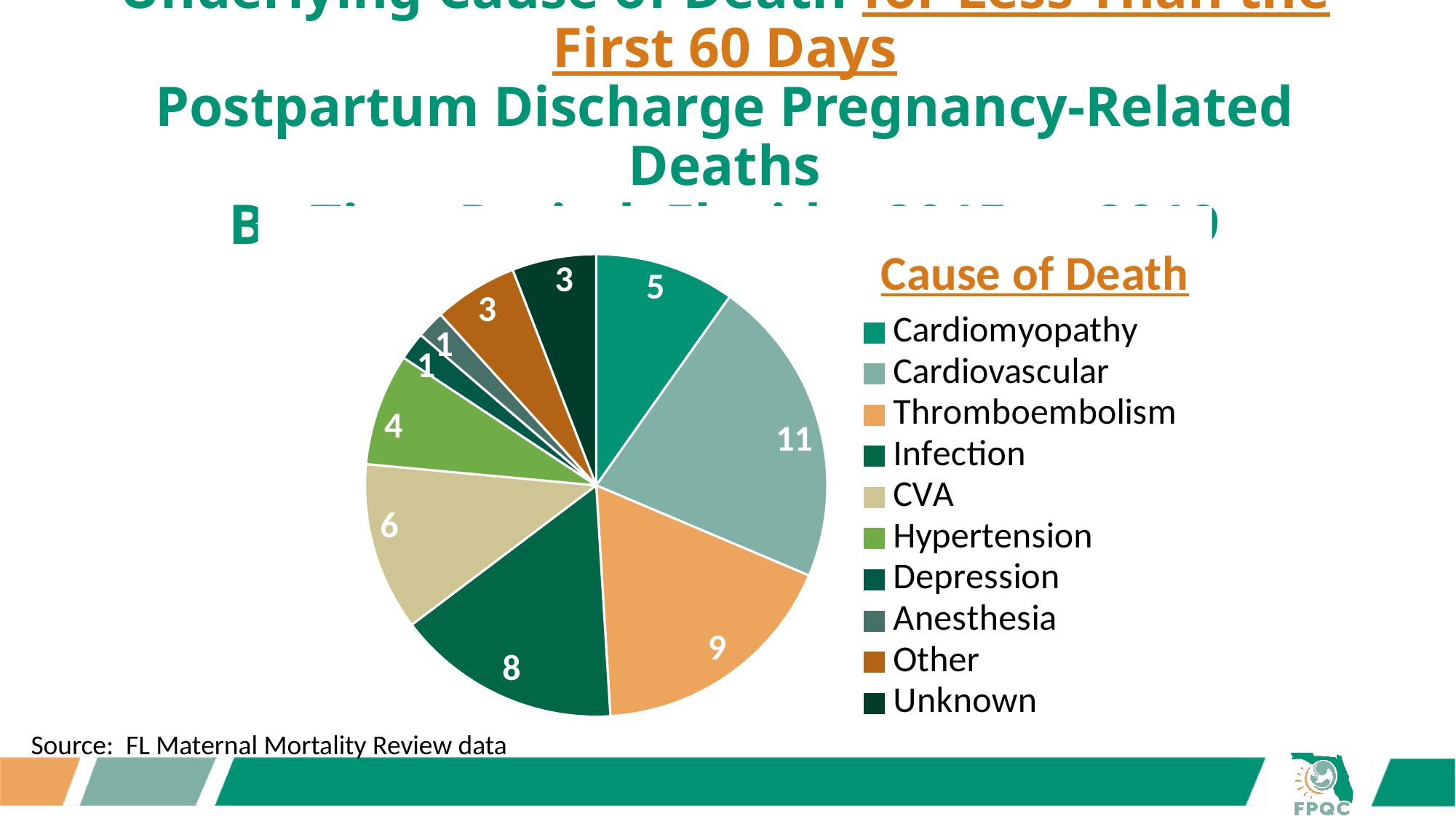
What kind of chart is shown on the slide? Pie chart Which causes of death have the smallest slices in the pie chart? Depression and Anesthesia What is the value for Hypertension in the pie chart? 4 Which is larger, the value for Infection or the value for CVA? Infection Which cause of death has the largest slice in the pie chart? Cardiovascular What is the difference between the values for Cardiovascular and Cardiomyopathy? 6 What is the value for CVA in the pie chart? 6 How many causes of death are shown in the pie chart? 10 What is the title of the chart's legend? Cause of Death What is the difference between the values for Thromboembolism and Infection? 1 What is the value for Thromboembolism in the pie chart? 9 What is the value for Cardiovascular in the pie chart? 11